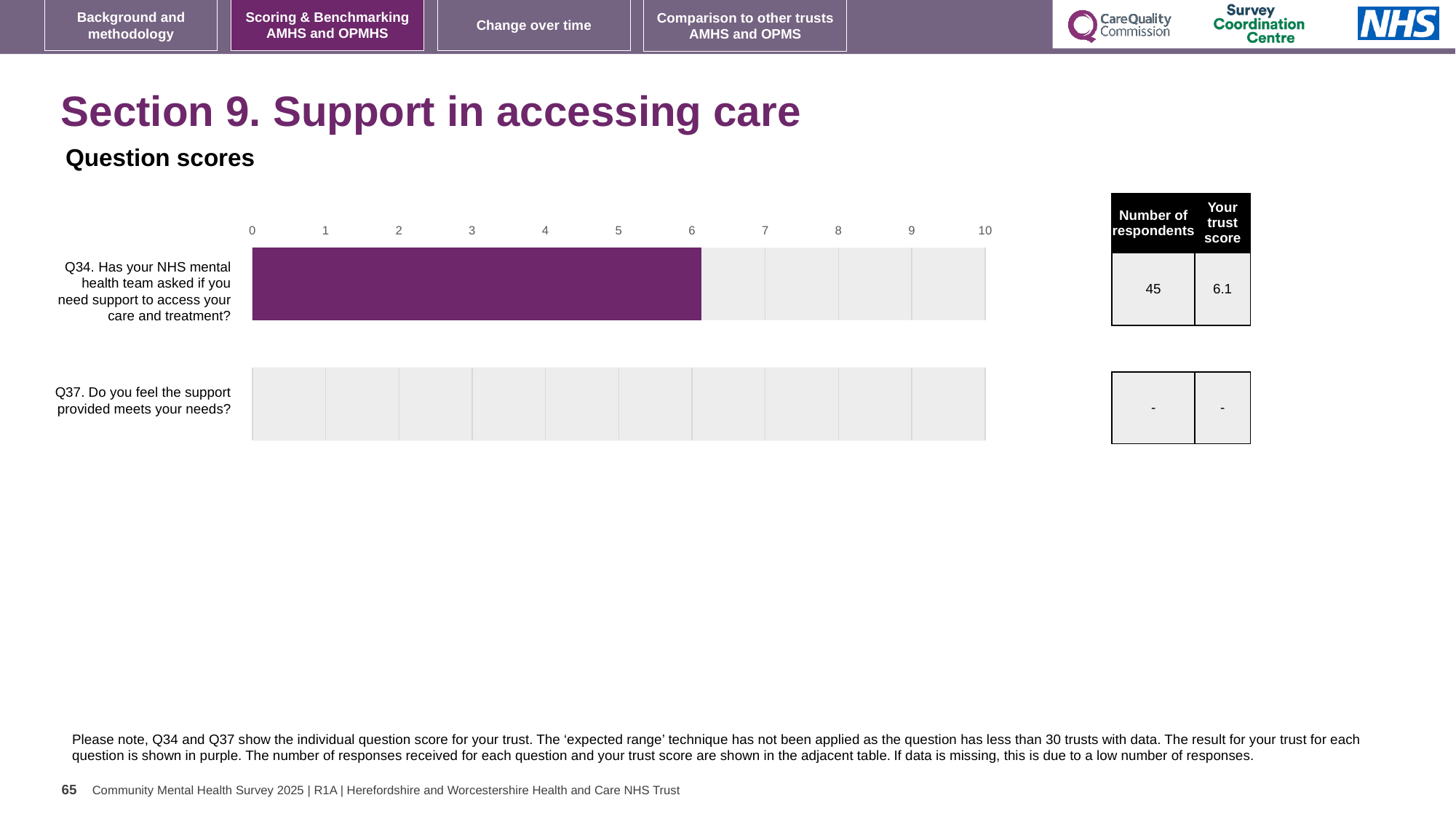
Is the value for Q34 greater or less than 5? greater What is the trust score for Q34 shown in the table next to the chart? 6.1 What kind of chart is shown on the slide? bar chart How many respondents answered Q34 according to the table? 45 Is the value for Q34 greater or less than 7? less Which question on the chart has no bar plotted and shows '-' in the table? Q37 What is the trust score shown in the table for Q37? - How many questions are listed as categories on the chart? 2 What is the maximum value shown on the chart's horizontal axis? 10